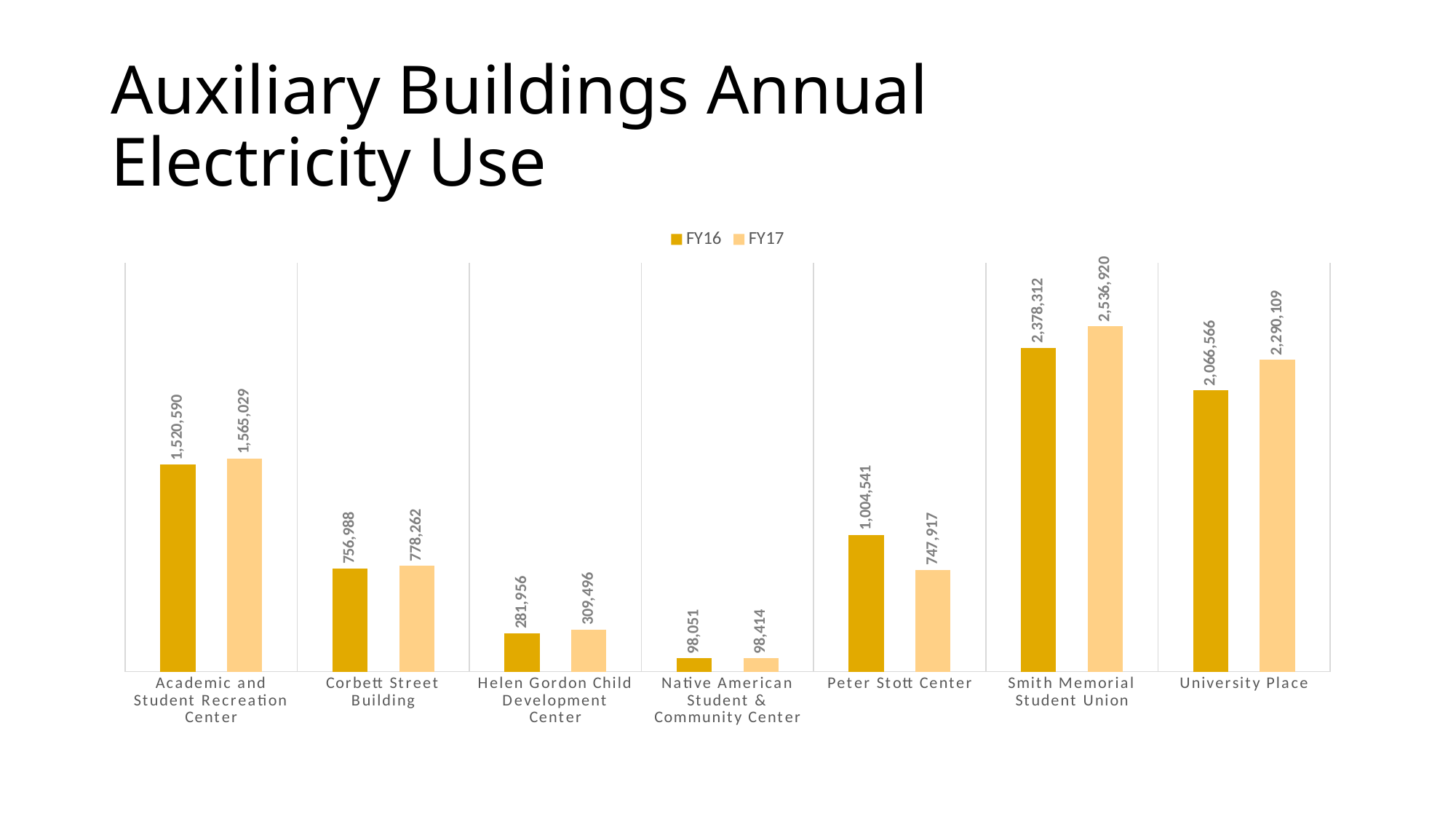
Which building has the highest FY17 electricity use? Smith Memorial Student Union Which is larger, the FY17 value for University Place or the FY17 value for Academic and Student Recreation Center? University Place What is the FY17 value for Helen Gordon Child Development Center? 309,496 What type of chart is shown on the slide? Bar chart What is the difference between the FY16 and FY17 values for Peter Stott Center? 256,624 What is the FY17 electricity use for Peter Stott Center? 747,917 Which building has the lowest FY16 electricity use? Native American Student & Community Center How many buildings are shown on the x axis? 7 By how much did Smith Memorial Student Union's electricity use increase from FY16 to FY17? 158,608 For Peter Stott Center, which is larger, the FY16 value or the FY17 value? FY16 How many series does the legend list? 2 What is the FY16 electricity use for Smith Memorial Student Union? 2,378,312